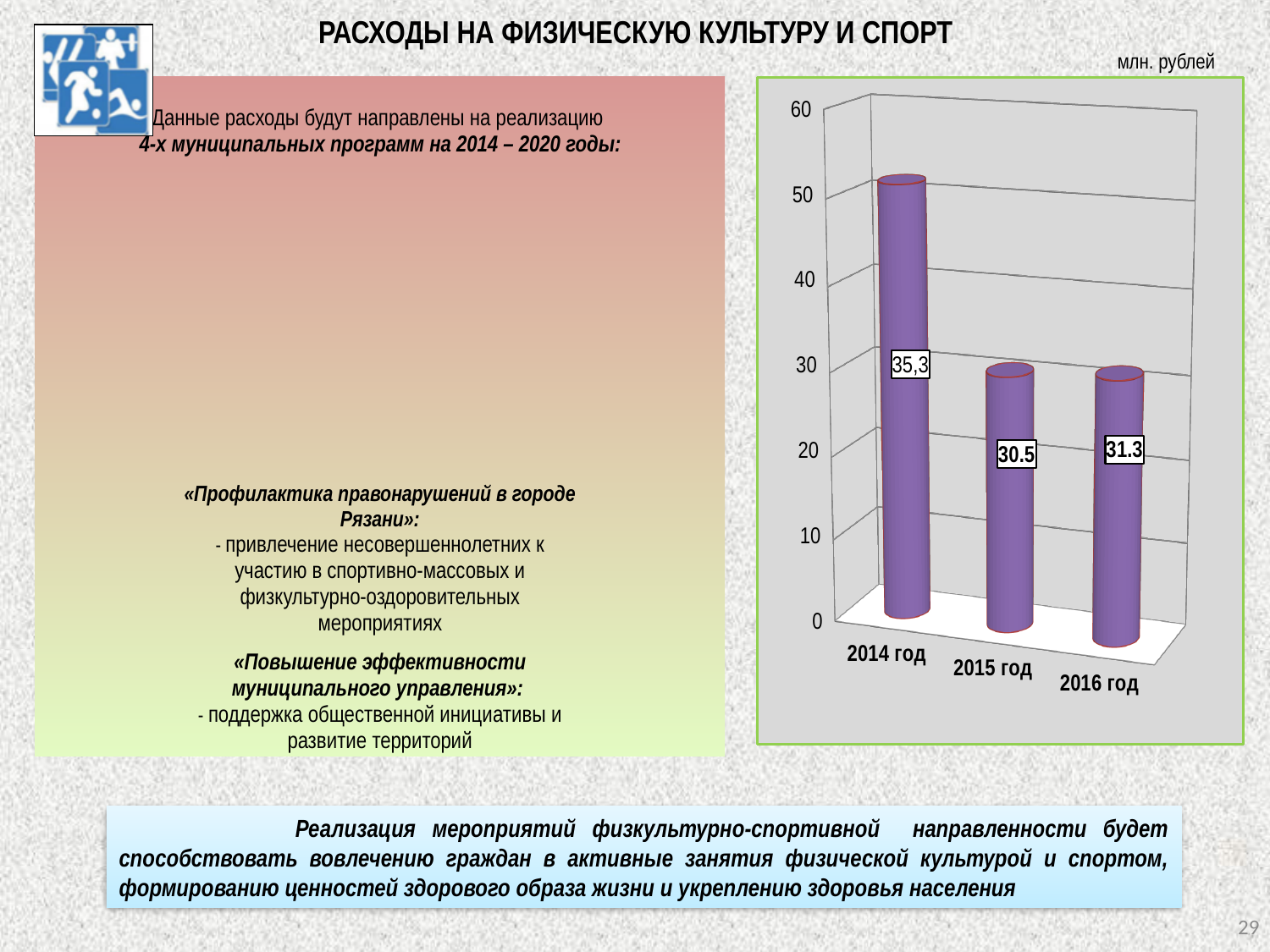
Which year has the highest value? 2014 год Which year has the lowest value? 2015 год In what units are the chart values given? млн. рублей What value is shown for 2015 год? 30.5 Is the value for 2016 год greater or less than 20? greater What value is shown for 2014 год? 35,3 What kind of chart is shown? bar chart What is the difference between the values for 2016 год and 2015 год? 0.8 How many years are shown on the chart? 3 Which is larger, the value for 2015 год or 2016 год? 2016 год Is the value for 2015 год greater or less than 40? less What value is shown for 2016 год? 31.3